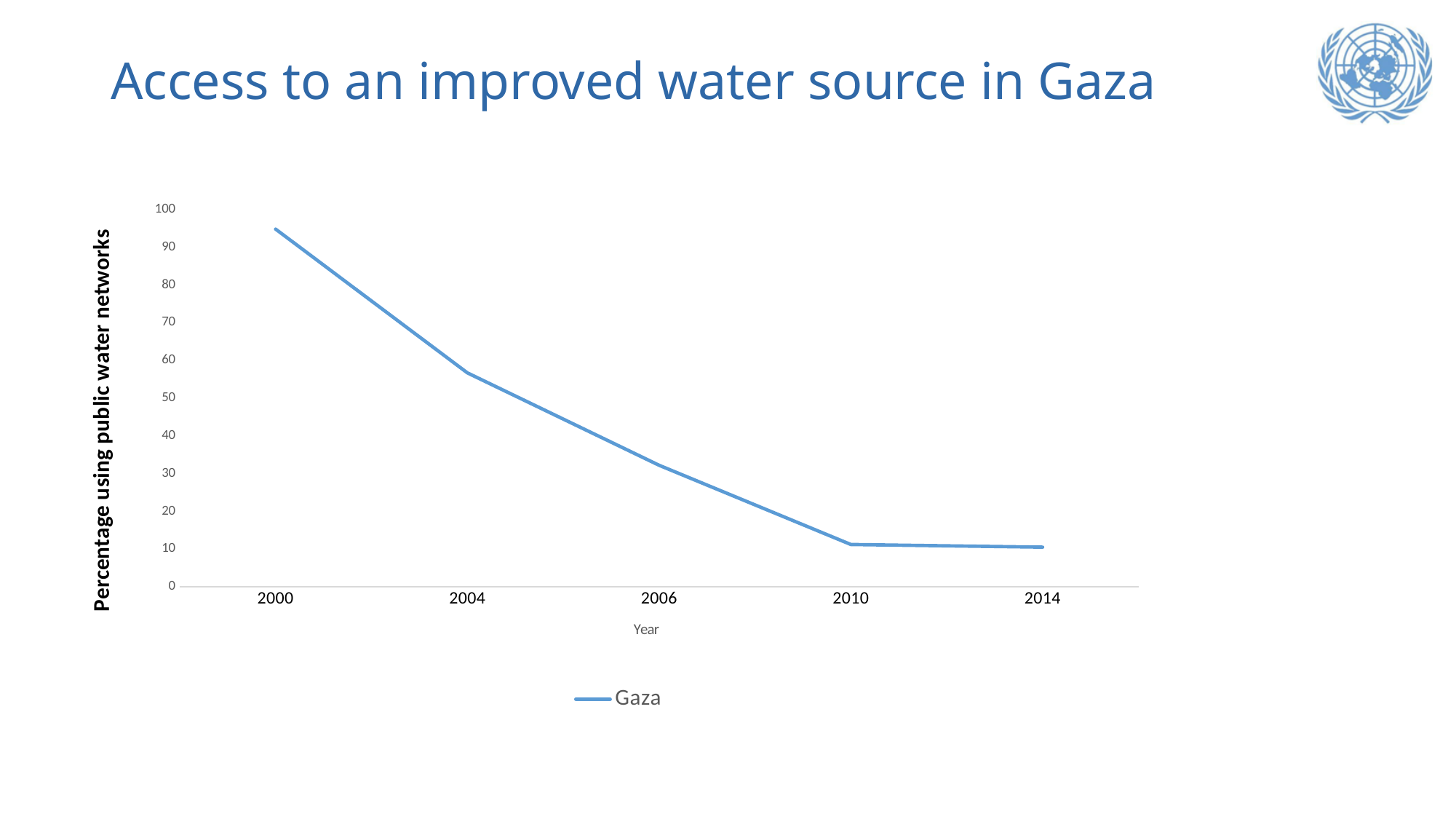
Is the value for 2000 greater or less than 90? greater Which year has the highest percentage using public water networks? 2000 What kind of chart is shown on the slide? line chart Which is larger, the value for 2004 or the value for 2006? 2004 Which year has the lowest percentage using public water networks? 2014 How many years are plotted on the x axis? 5 How many series does the legend list? 1 Is the value for 2006 greater or less than 40? less Is the value for 2004 greater or less than 60? less Do the values rise or fall from 2000 to 2014? fall What is the label on the y axis? Percentage using public water networks